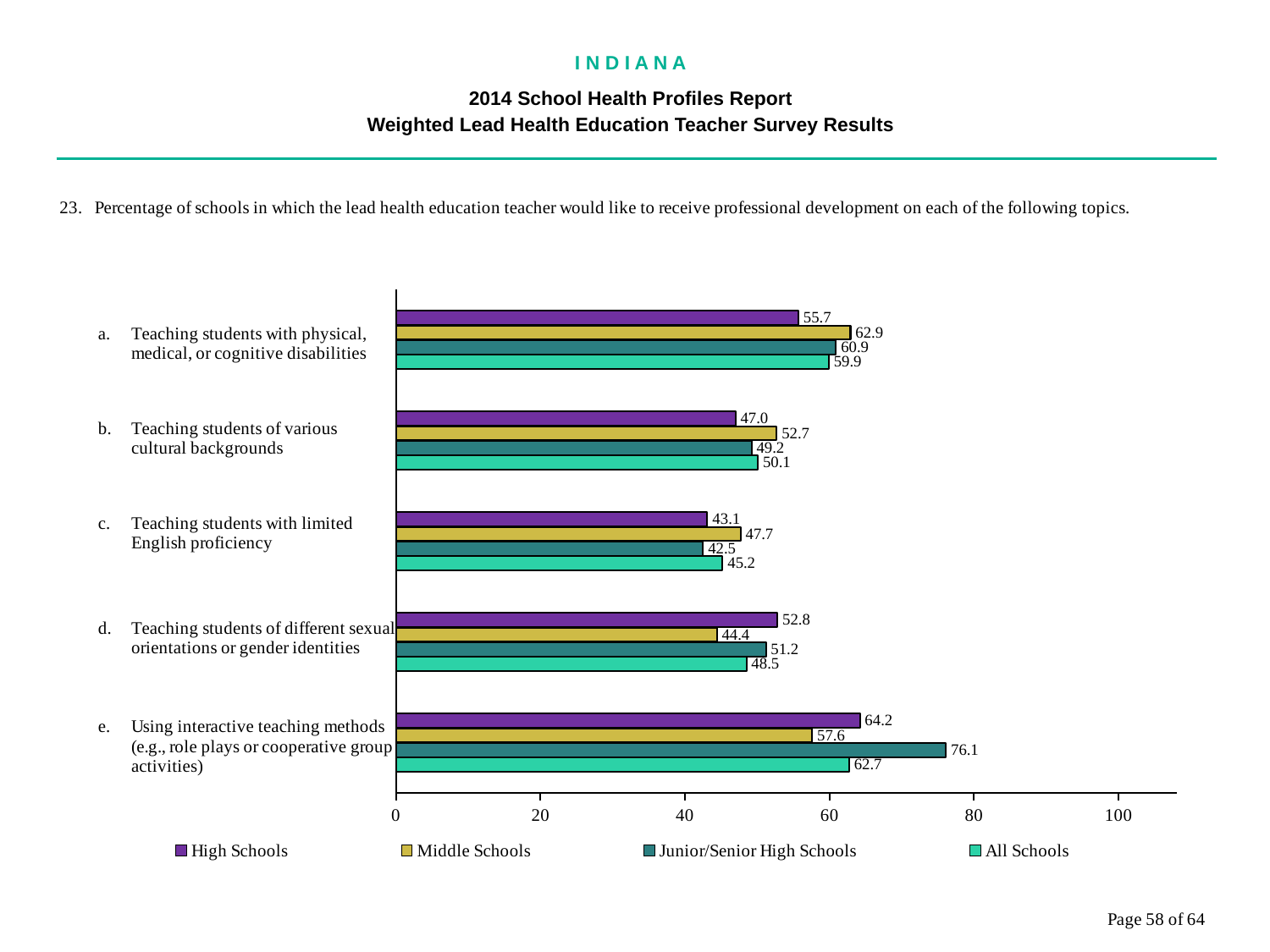
Which topic has the highest value for Junior/Senior High Schools? e. Using interactive teaching methods Which topic has the lowest value for High Schools? c. Teaching students with limited English proficiency How many topics are shown on the chart? 5 What is the value for Junior/Senior High Schools for topic e, using interactive teaching methods? 76.1 Is the Junior/Senior High Schools value for topic e greater or less than 80? less What is the difference between the Junior/Senior High Schools and Middle Schools values for topic e, using interactive teaching methods? 18.5 What kind of chart is shown on the slide? Bar chart What is the All Schools value for topic c, teaching students with limited English proficiency? 45.2 For topic b, teaching students of various cultural backgrounds, which is larger: the Middle Schools value or the High Schools value? Middle Schools What is the value for High Schools for topic a, teaching students with physical, medical, or cognitive disabilities? 55.7 What is the value for Middle Schools for topic d, teaching students of different sexual orientations or gender identities? 44.4 How many series does the legend list? 4